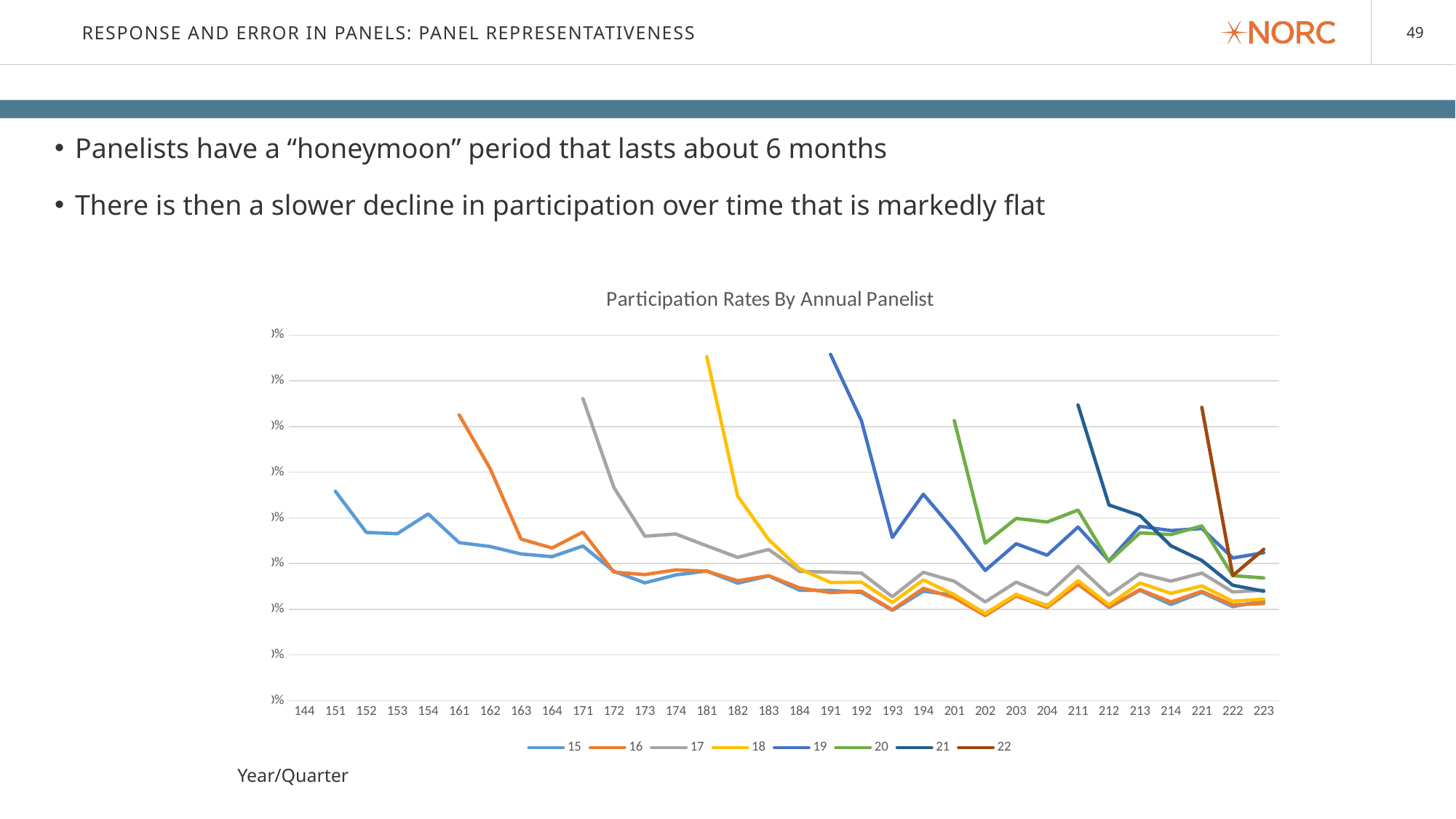
How many series does the legend list? 8 How many Year/Quarter categories are shown on the x axis? 32 Which is higher: the starting value of series 17 at 171 or the starting value of series 16 at 161? series 17 at 171 Which is higher: the starting value of series 19 at 191 or the starting value of series 20 at 201? series 19 at 191 What kind of chart is shown on the slide? line chart At which Year/Quarter does the line for series 15 first appear? 151 Does the line for series 16 rise or fall from 161 to 223? fall What is the label of the x axis? Year/Quarter What is the title of the chart? Participation Rates By Annual Panelist At 223, which is higher: series 17 or series 16? series 17 At which Year/Quarter does the line for series 22 first appear? 221 Does the line for series 22 rise or fall from 221 to 222? fall